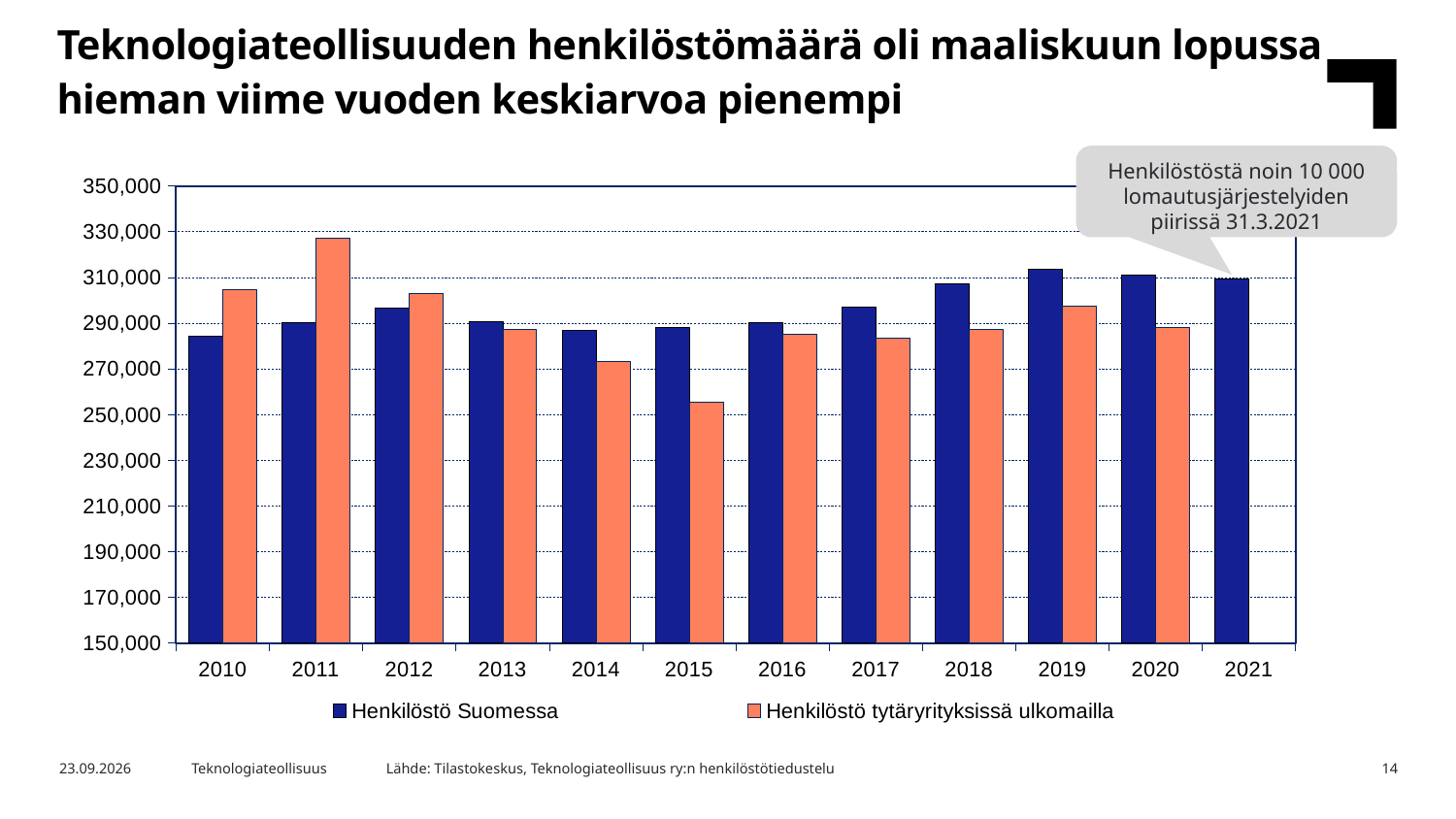
In 2011, which is larger: Henkilöstö Suomessa or Henkilöstö tytäryrityksissä ulkomailla? Henkilöstö tytäryrityksissä ulkomailla How many series does the chart legend list? 2 How many years are shown on the x axis of the chart? 12 Is the value for Henkilöstö Suomessa in 2019 greater or less than 290,000? greater Does the value for Henkilöstö Suomessa rise or fall from 2015 to 2019? rise Is the value for Henkilöstö tytäryrityksissä ulkomailla in 2011 greater or less than 310,000? greater Is the value for Henkilöstö tytäryrityksissä ulkomailla in 2015 greater or less than 270,000? less Which year has the lowest value for Henkilöstö tytäryrityksissä ulkomailla? 2015 What kind of chart is shown on the slide? bar chart In 2015, which is larger: Henkilöstö Suomessa or Henkilöstö tytäryrityksissä ulkomailla? Henkilöstö Suomessa What colour are the bars for Henkilöstö Suomessa? dark blue Which year has the highest value for Henkilöstö tytäryrityksissä ulkomailla? 2011